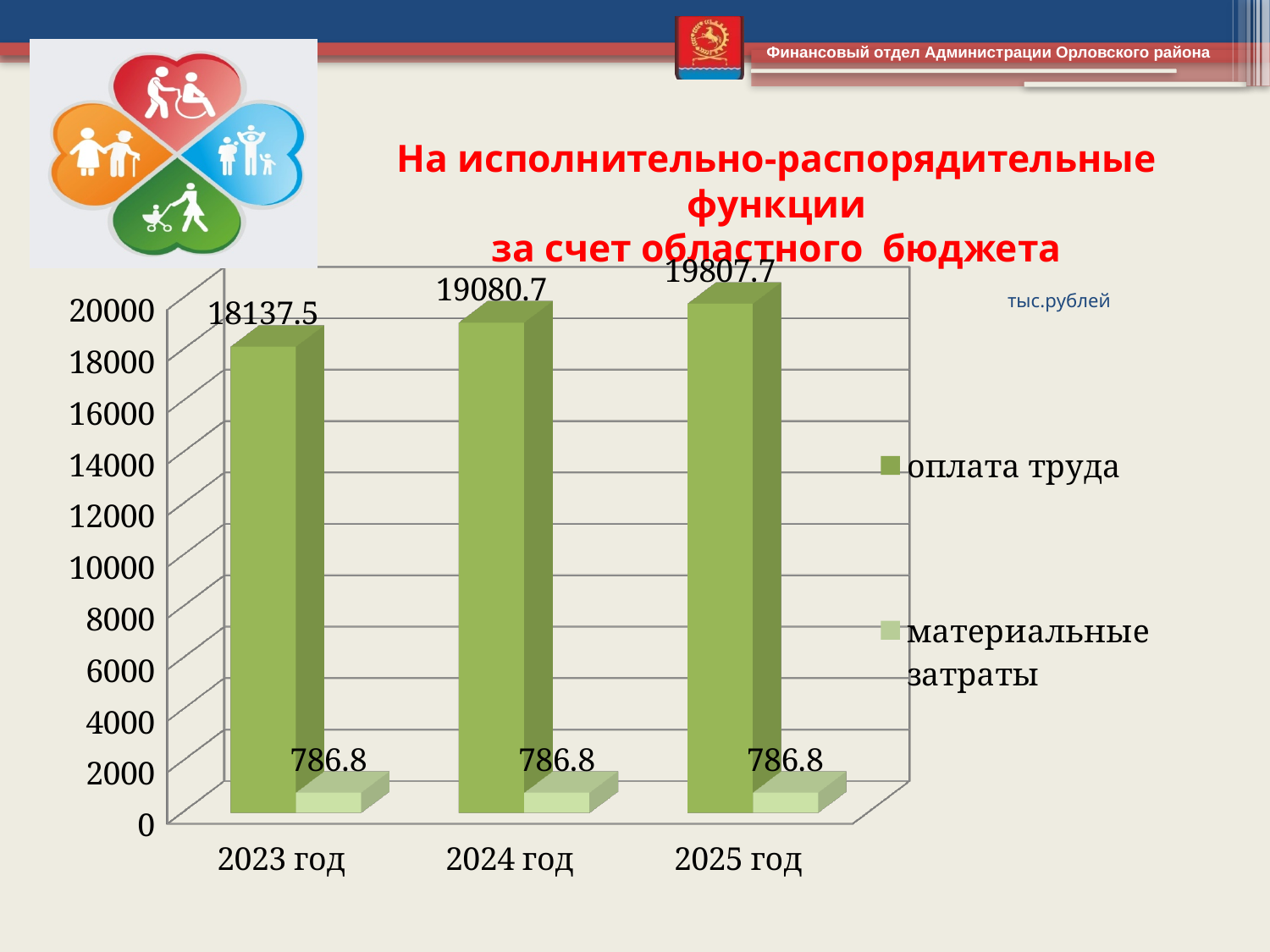
Which is larger: оплата труда in 2024 год or in 2025 год? 2025 год Is the value of оплата труда for 2024 год greater or less than 18000? greater Which year has the highest value for оплата труда? 2025 год What is the difference between оплата труда in 2025 год and 2023 год? 1670.2 How many series does the legend list? 2 How many years are shown on the x axis? 3 What is the value of оплата труда for 2023 год? 18137.5 What is the value of оплата труда for 2025 год? 19807.7 What kind of chart is shown on the slide? bar chart What is the value of материальные затраты for 2024 год? 786.8 What is the difference between оплата труда in 2024 год and 2023 год? 943.2 Which year has the lowest value for оплата труда? 2023 год